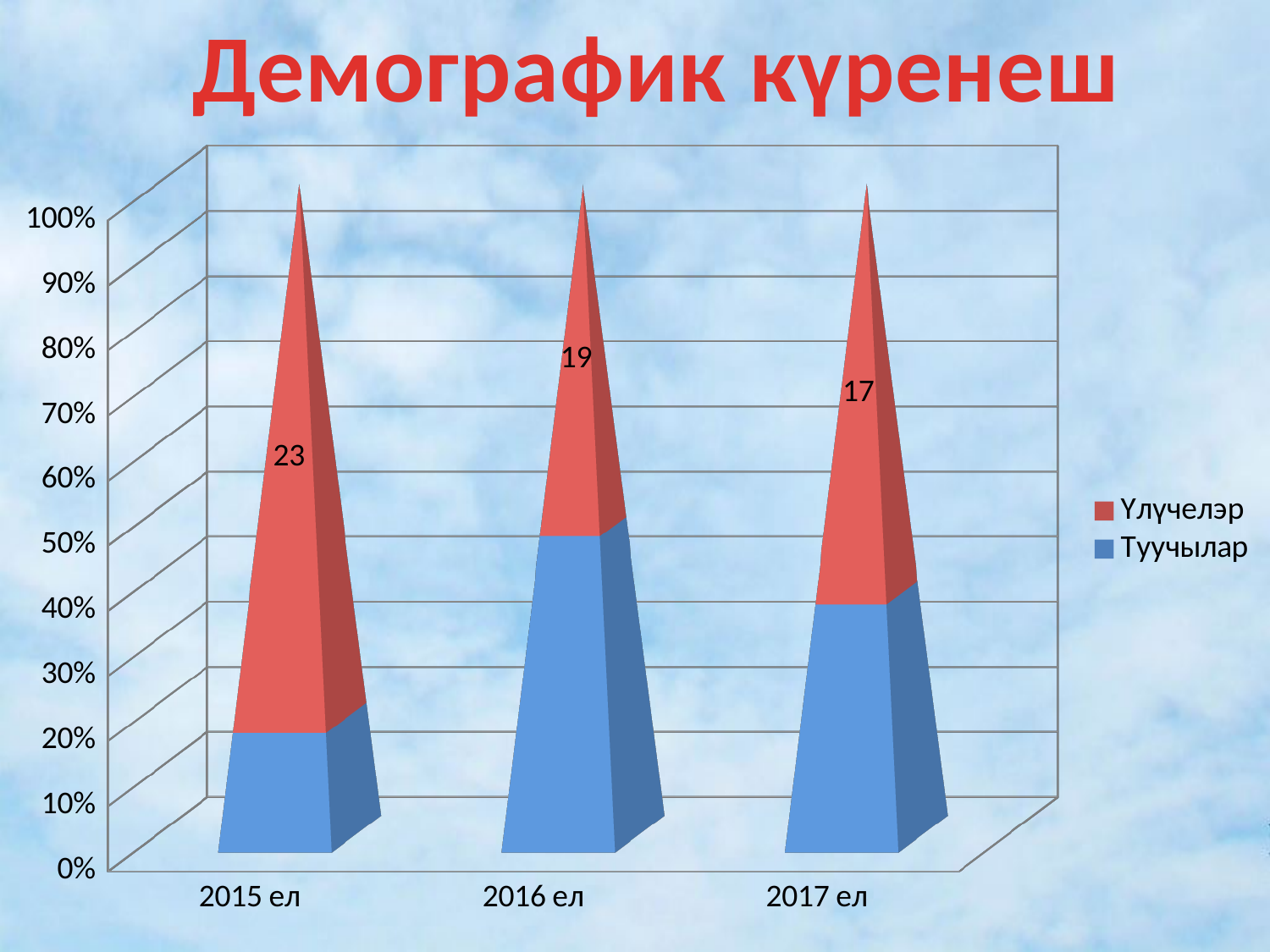
How many series does the legend list? 2 Do the labelled Үлүчелэр values rise or fall from 2015 ел to 2017 ел? fall Which is larger, the Үлүчелэр value for 2016 ел or for 2017 ел? 2016 ел What is the value labelled for Үлүчелэр in 2017 ел? 17 What is the value labelled for Үлүчелэр in 2015 ел? 23 How many years are shown on the x axis? 3 Is the Туучылар share for 2015 ел greater or less than 30%? less What is the value labelled for Үлүчелэр in 2016 ел? 19 Is the Туучылар share for 2016 ел greater or less than 40%? greater What is the difference between the Үлүчелэр values for 2015 ел and 2017 ел? 6 In which year is the labelled Үлүчелэр value lowest? 2017 ел In which year is the labelled Үлүчелэр value highest? 2015 ел